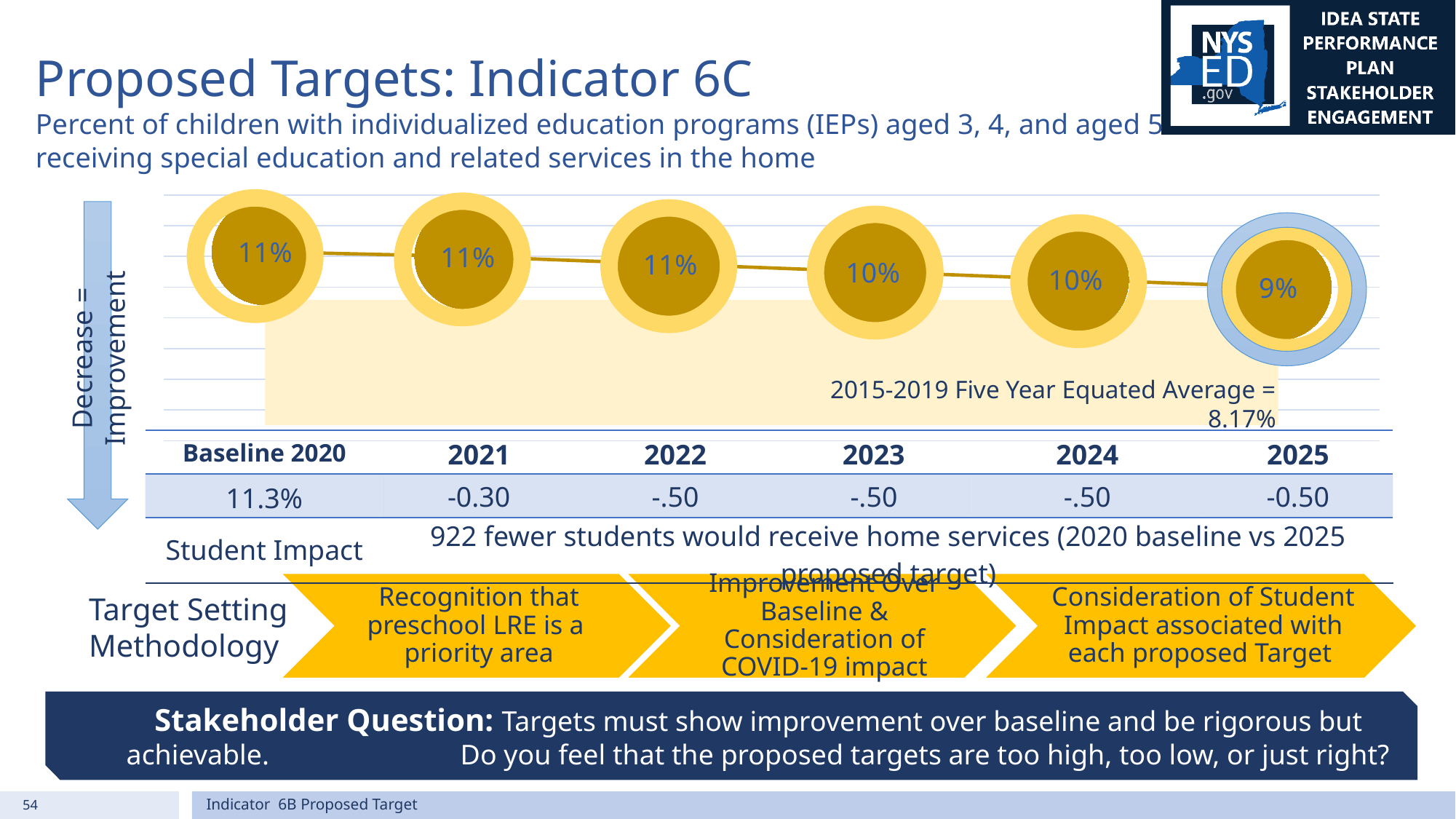
What is the 2015-2019 Five Year Equated Average shown on the chart? 8.17% What is the plotted value for 2023? 10% What is the plotted value for Baseline 2020? 11% Do the plotted values rise or fall from Baseline 2020 to 2025? fall Which year has the lowest plotted value? 2025 What baseline value is shown in the table row for Baseline 2020? 11.3% How many data points are plotted on the chart? 6 What is the plotted value for 2025? 9% What kind of chart is shown on the slide? combination area and line chart What value is shown in the table row for 2021? -0.30 Which is larger, the plotted value for 2021 or for 2025? 2021 What is the difference between the plotted values for Baseline 2020 and 2025? 2%